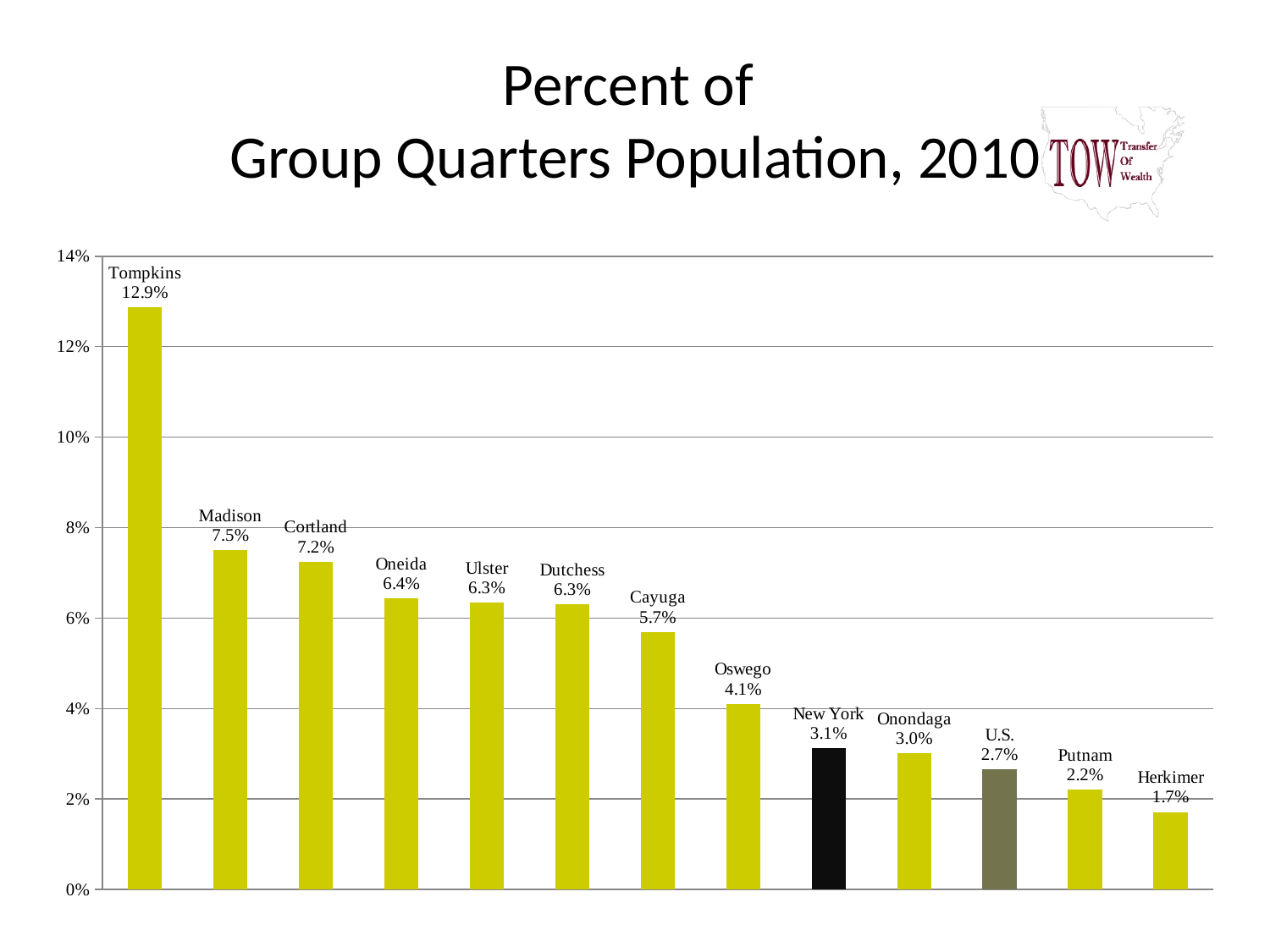
Which category has the lowest percent of group quarters population? Herkimer What is the value shown for Oswego? 4.1% Is the value for New York greater or less than 4%? less Which is larger, the value for Oneida or the value for Cayuga? Oneida Do the values rise or fall from left to right along the x axis? fall What is the percent of group quarters population for Tompkins? 12.9% Which category has the highest percent of group quarters population? Tompkins What is the difference between the values for Madison and Cortland? 0.3% How many bars are plotted on the chart? 13 What kind of chart is shown on the slide? bar chart What is the value shown for the U.S.? 2.7% What is the difference between the values for Tompkins and Herkimer? 11.2%